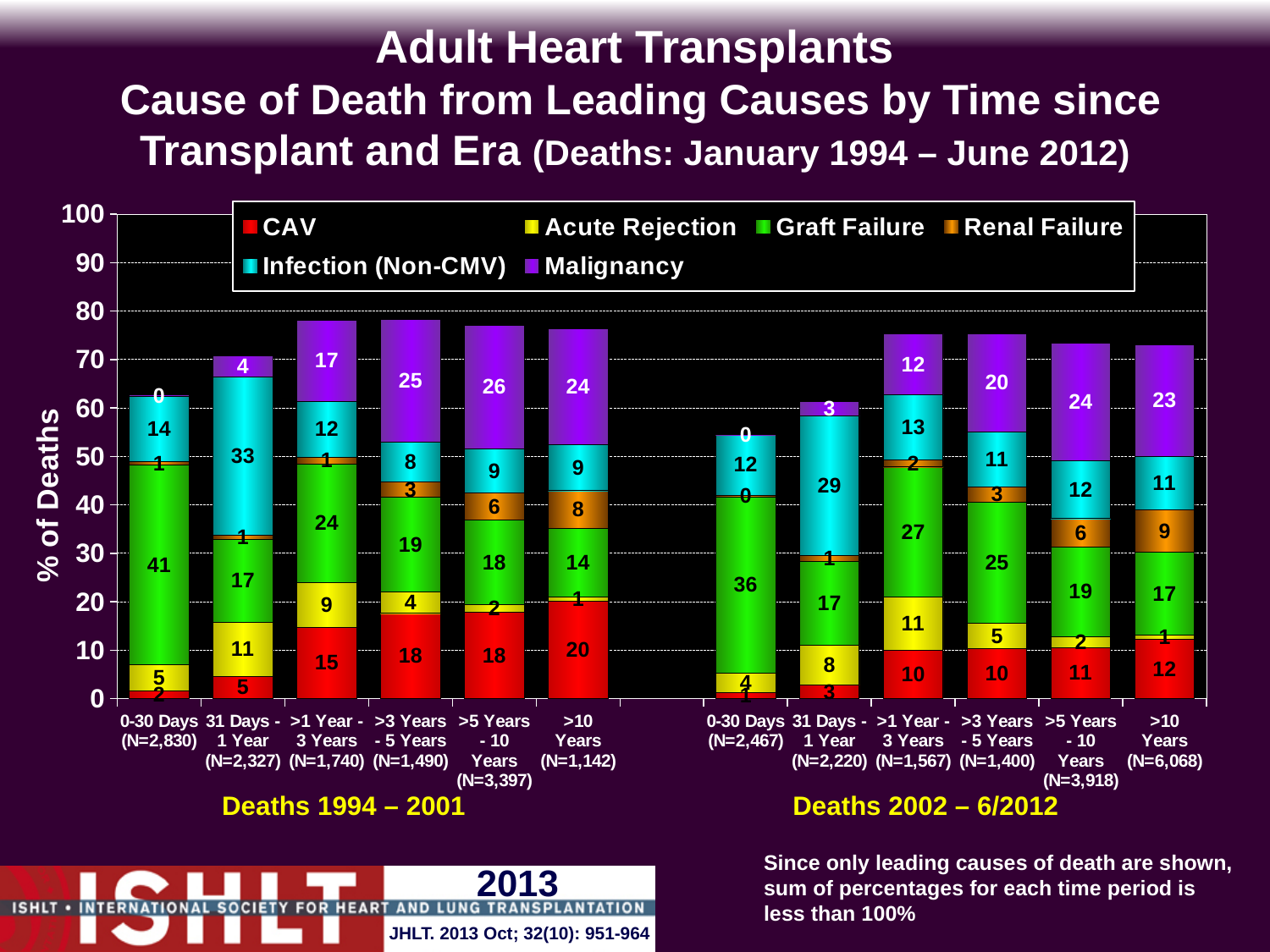
Which is larger: the Malignancy value for >3 Years - 5 Years in the Deaths 1994 – 2001 group or in the Deaths 2002 – 6/2012 group? Deaths 1994 – 2001 What is the difference between the Graft Failure value for 0-30 Days in the Deaths 1994 – 2001 group and the Graft Failure value for 0-30 Days in the Deaths 2002 – 6/2012 group? 5 In the Deaths 2002 – 6/2012 group, does the Malignancy value rise or fall from 0-30 Days to >3 Years - 5 Years? Rise In the Deaths 1994 – 2001 group, which time period has the highest CAV value? >10 Years What is the Infection (Non-CMV) value for 31 Days - 1 Year in the Deaths 2002 – 6/2012 group? 29 How many time-period categories are shown in the Deaths 2002 – 6/2012 group? 6 How many series does the legend list? 6 What kind of chart is shown on the slide? Stacked bar chart What is the CAV value for >10 Years in the Deaths 2002 – 6/2012 group? 12 What is the Graft Failure value for 0-30 Days in the Deaths 1994 – 2001 group? 41 What is the Malignancy value for >5 Years - 10 Years in the Deaths 1994 – 2001 group? 26